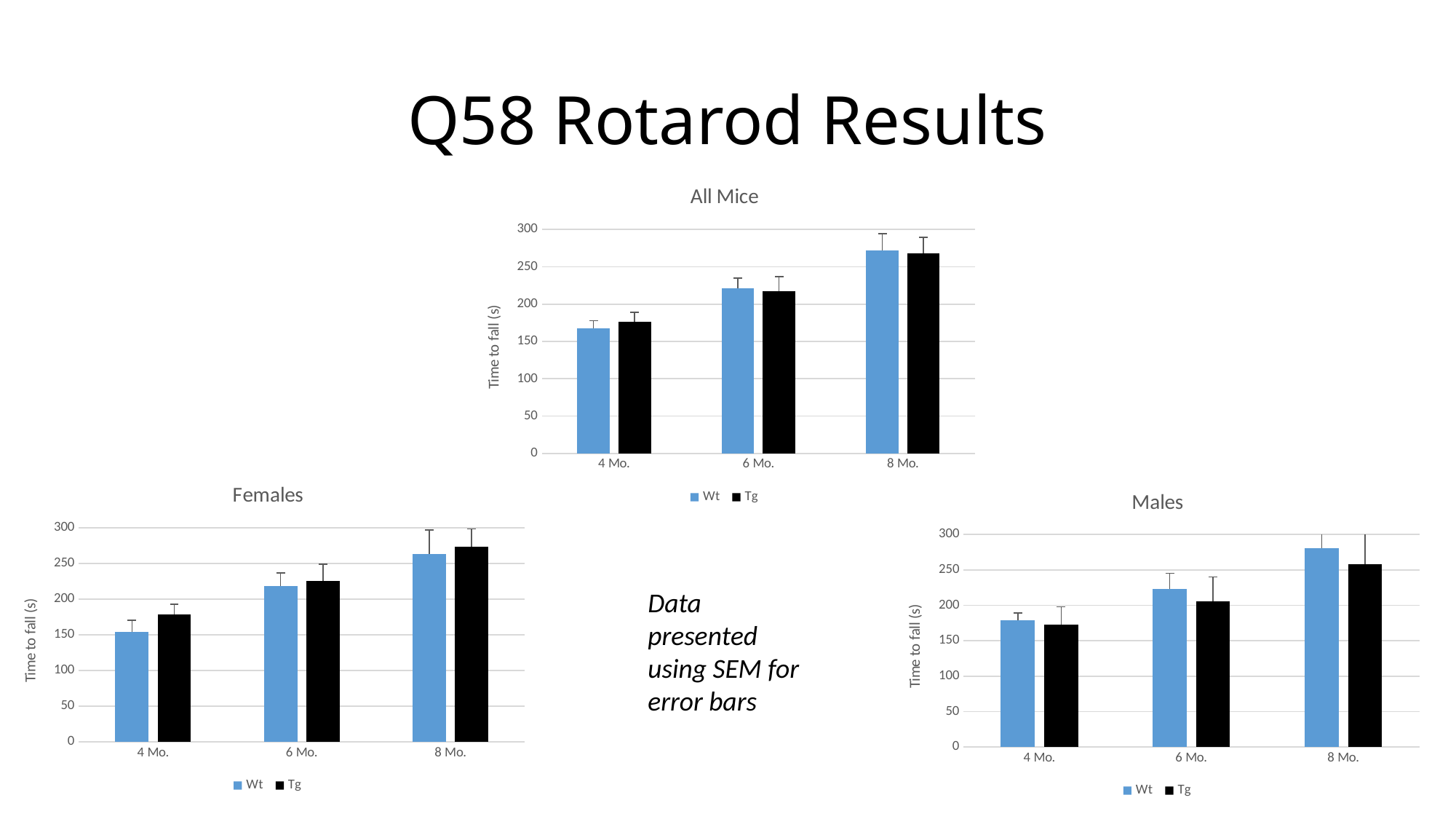
In the All Mice chart, at which age are the values highest? 8 Mo. In the Males chart, is the value for Wt at 6 Mo. greater or less than 200? greater In the Males chart, which is larger at 8 Mo., Wt or Tg? Wt How many series does the legend of the All Mice chart list? 2 In the Females chart, is the value for Tg at 8 Mo. greater or less than 250? greater In the Males chart, do the Wt values rise or fall from 4 Mo. to 8 Mo.? rise In the Females chart, which is larger at 4 Mo., Wt or Tg? Tg In the All Mice chart, is the value for Wt at 8 Mo. greater or less than 250? greater How many age categories are shown on the x axis of the Females chart? 3 In the Females chart, which bar is the lowest? Wt at 4 Mo. What kind of chart is the Males chart? bar chart